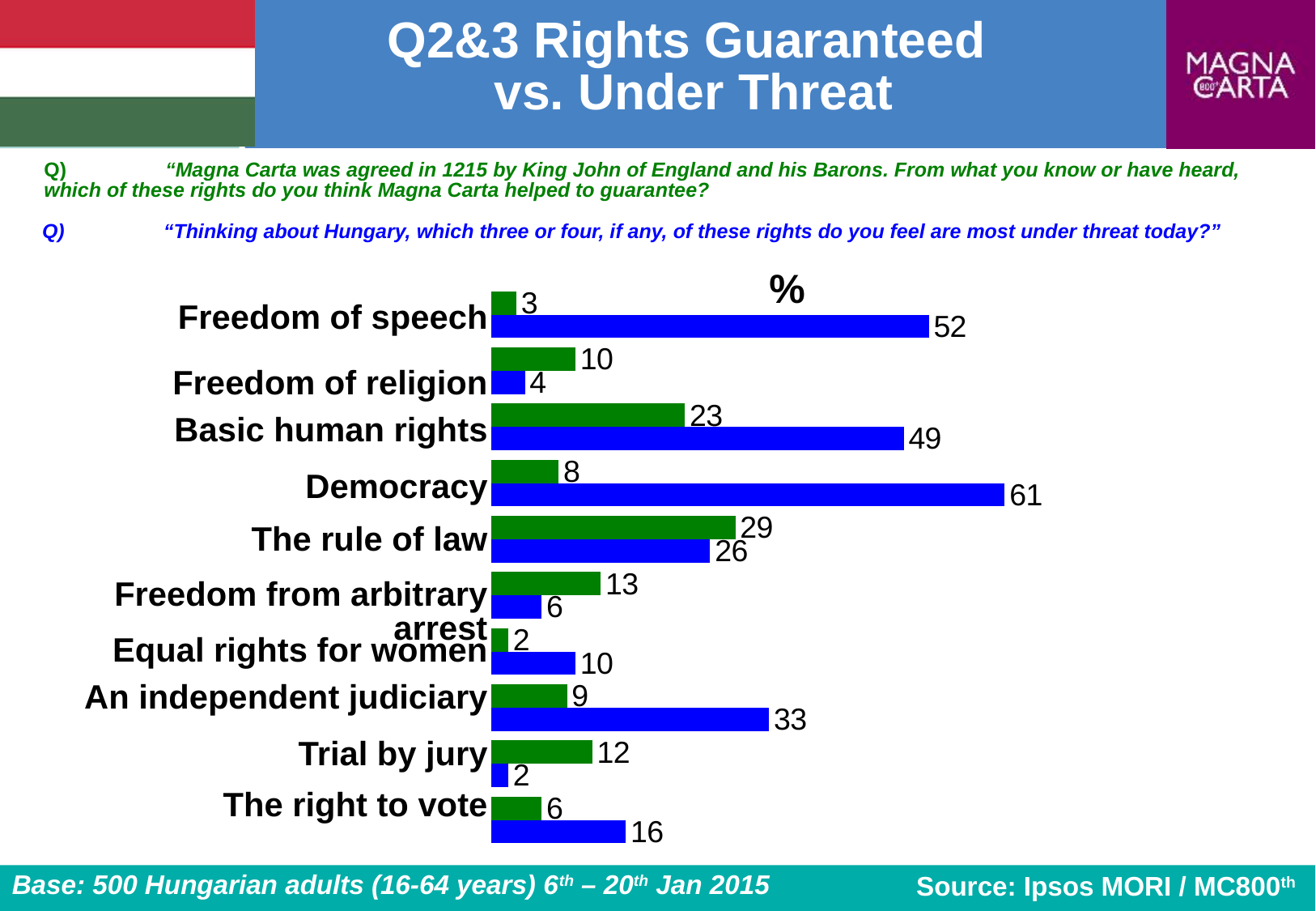
What is the value of the blue bar for Democracy? 61 How many rights (categories) are listed on the chart? 10 What is the value of the green bar for The rule of law? 29 What is the difference between the blue and green bar values for Freedom of speech? 49 Which right has the highest green bar value? The rule of law What is the value of the green bar for Basic human rights? 23 What kind of chart is shown on the slide? bar chart What unit label is shown above the bars on the chart? % Which right has the highest blue bar value? Democracy For Trial by jury, which is larger: the green bar or the blue bar? the green bar What is the value of the blue bar for An independent judiciary? 33 Which right has the lowest green bar value? Equal rights for women